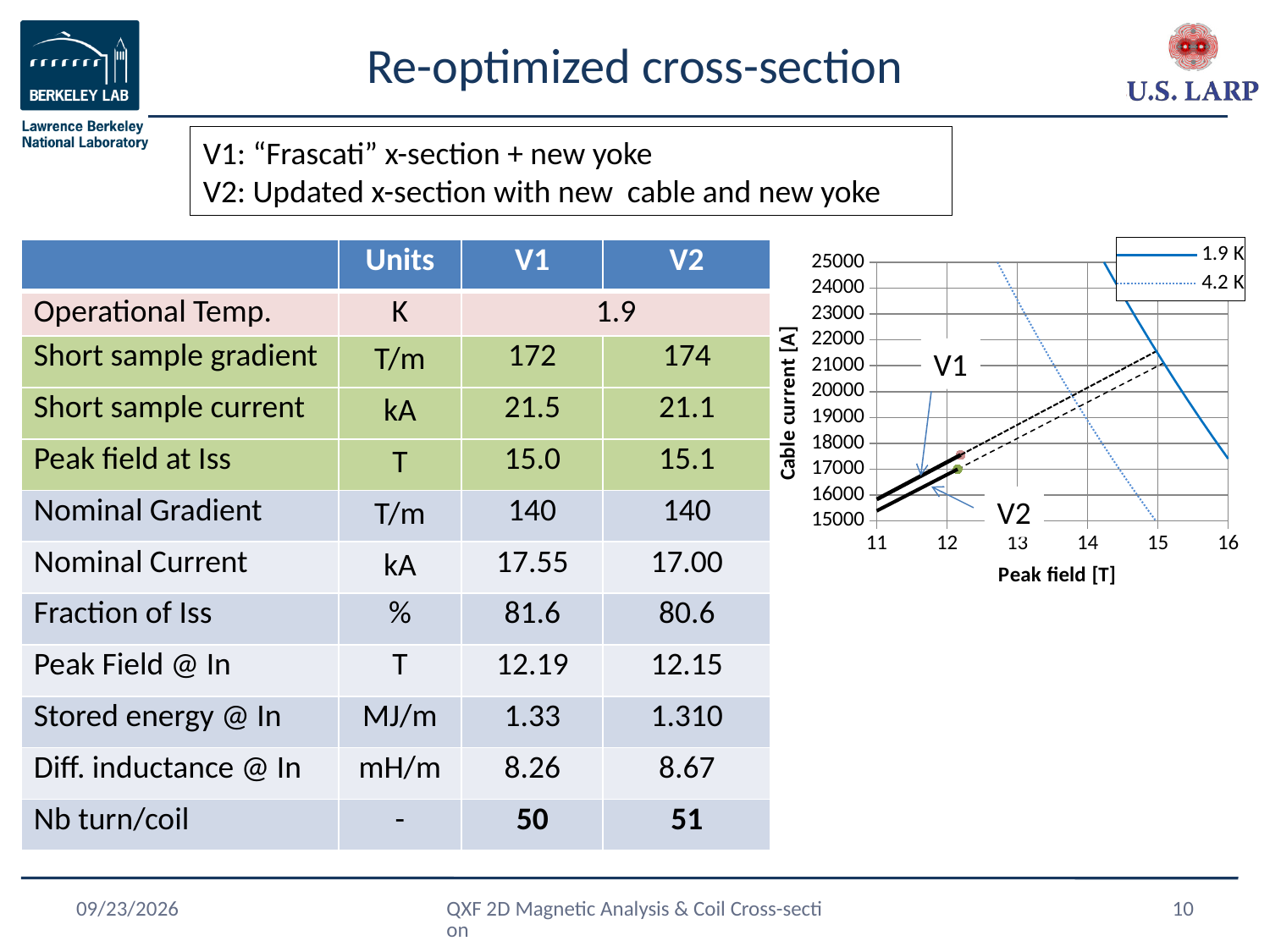
What kind of chart is shown on the right of the slide? line chart What is the label of the chart's x axis? Peak field [T] Is the cable current of the V1 marker point greater or less than 17000 A? greater How many tick labels are shown on the chart's x axis? 6 How many series does the chart legend list? 2 What is the highest value shown on the chart's y axis? 25000 Does the 1.9 K line rise or fall as peak field increases? fall Does the V1 load line rise or fall as peak field increases? rise Is the cable current of the 1.9 K line at a peak field of 16 T greater or less than 20000 A? less What are the two entries in the chart legend? 1.9 K and 4.2 K